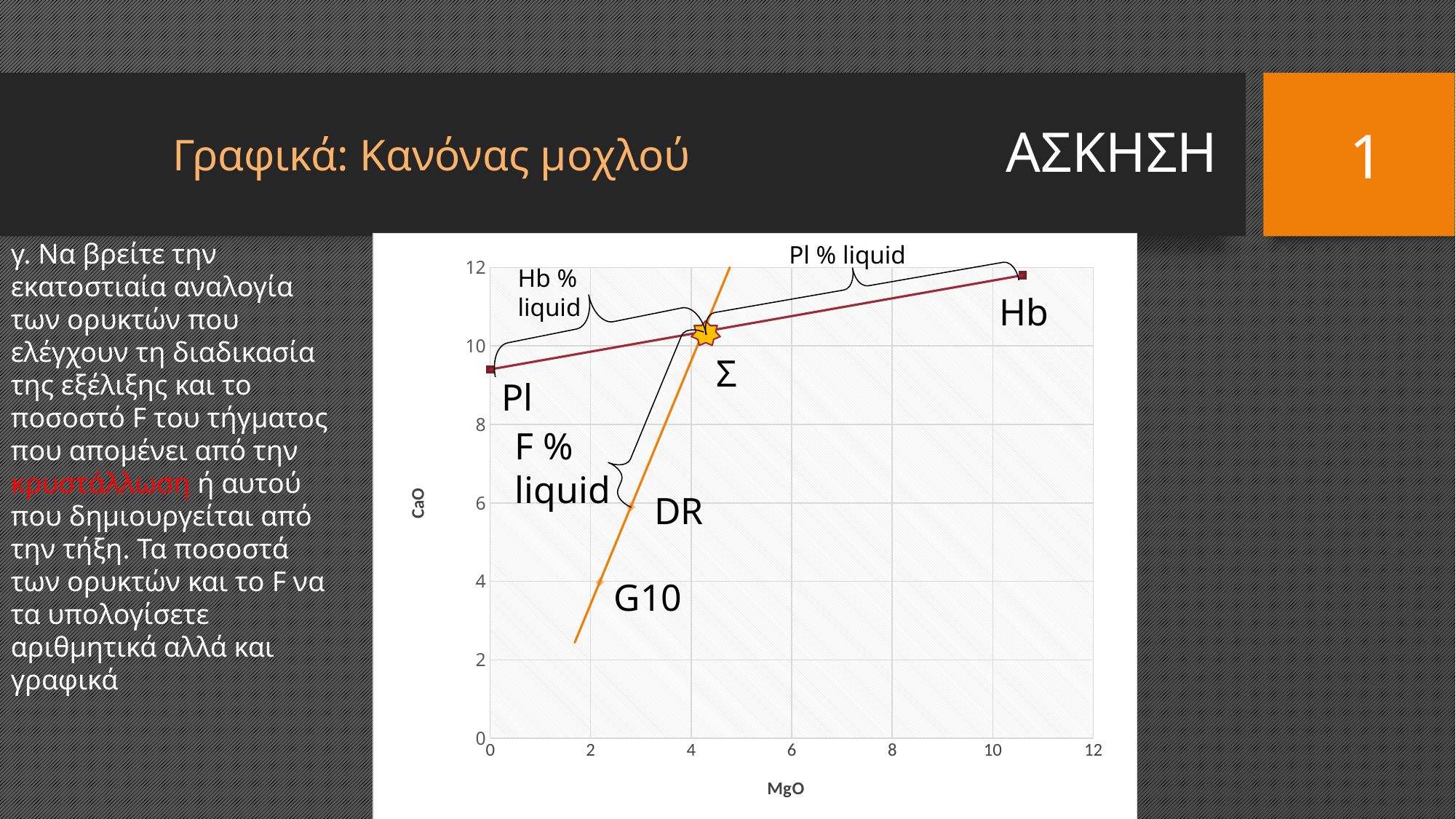
Is the CaO value for the point labelled Hb greater or less than 10? greater Which point has the higher CaO value, Hb or G10? Hb What is the maximum value shown on the x axis of the chart? 12 Which point has the lower MgO value, Pl or Σ? Pl Is the MgO value for the point labelled DR greater or less than 4? less What is the label of the y axis of the chart? CaO Which labelled point has the highest MgO value? Hb Is the CaO value for the point labelled Pl greater or less than 8? greater Which labelled point has the lowest CaO value? G10 What is the label of the x axis of the chart? MgO